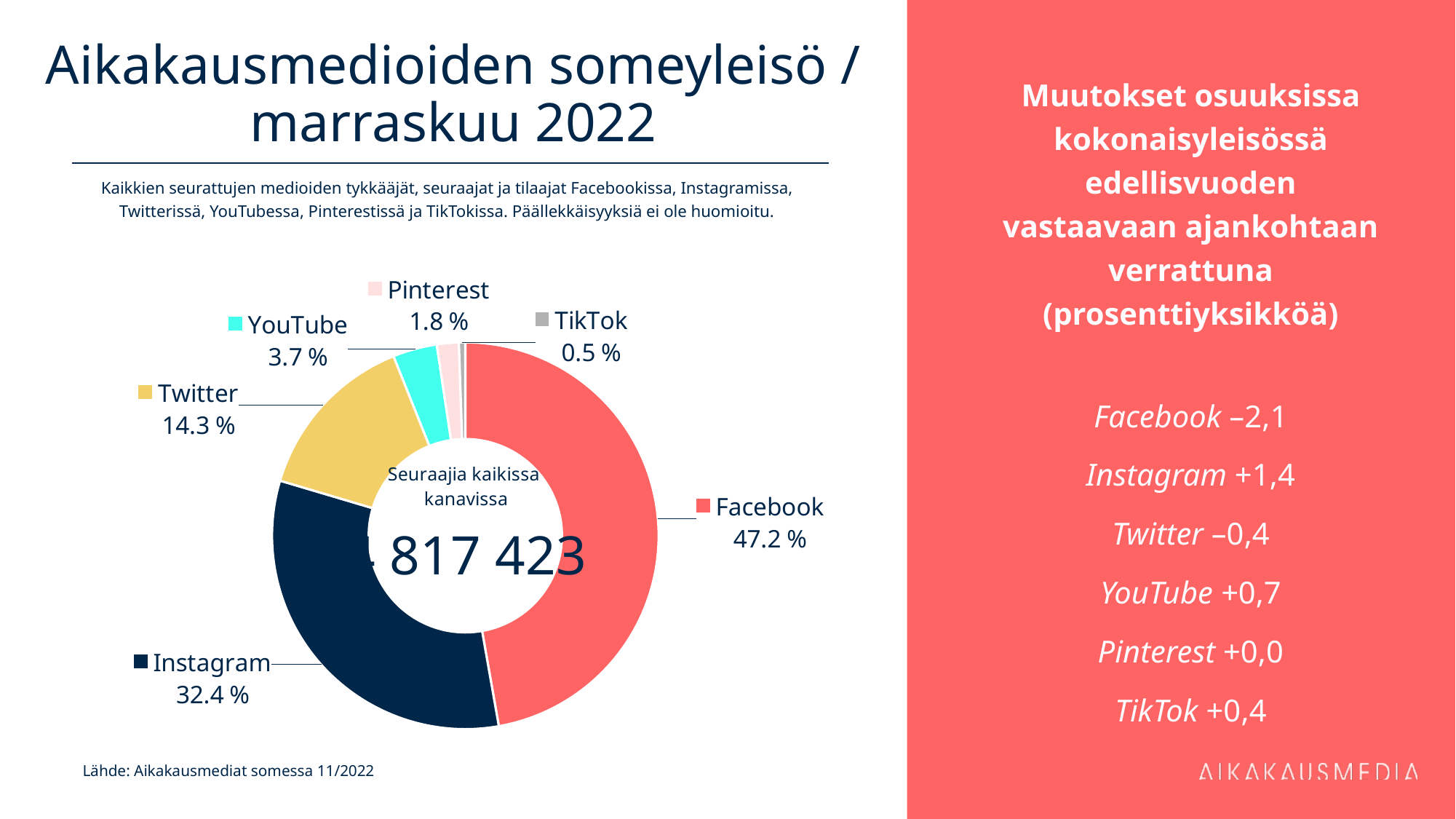
What kind of chart is shown on the slide? Pie chart (donut) What share of the social media audience does Instagram have? 32.4 % What share does Twitter have in the chart? 14.3 % How many channels are shown in the chart? 6 What share of the social media audience does Facebook have? 47.2 % What text is written in the centre of the donut chart above the number? Seuraajia kaikissa kanavissa Which has a larger share, Twitter or YouTube? Twitter What is the difference in percentage points between Facebook's and Instagram's shares? 14.8 Which channel has the largest share in the chart? Facebook Which channel has the smallest share in the chart? TikTok What share does TikTok have in the chart? 0.5 % What share does YouTube have in the chart? 3.7 %